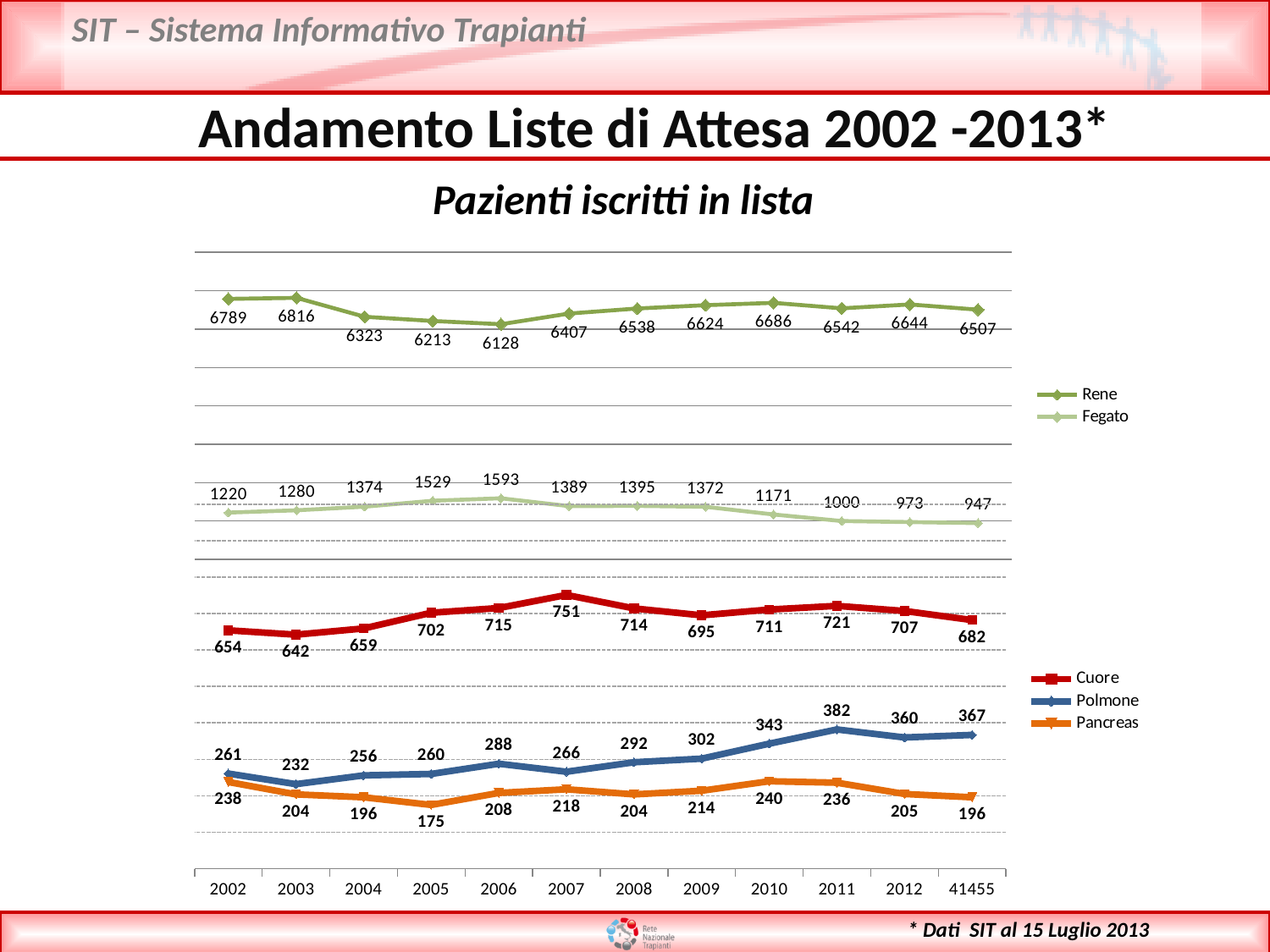
What is the title of the chart? Pazienti iscritti in lista In which year does the Fegato series reach its highest value? 2006 What kind of chart is shown on the slide? line chart Does the Fegato series rise or fall from 2006 to 2012? fall In which year does the Pancreas series have its lowest value? 2005 What is the value for Fegato in 2010? 1171 What is the difference between the Polmone value in 2011 and in 2002? 121 Which is larger for Cuore: the value in 2007 or the value in 2011? 2007 What is the value for Rene in 2006? 6128 How many series does the legend list? 5 What is the value for Cuore in 2012? 707 How many data points does the Rene series have? 12